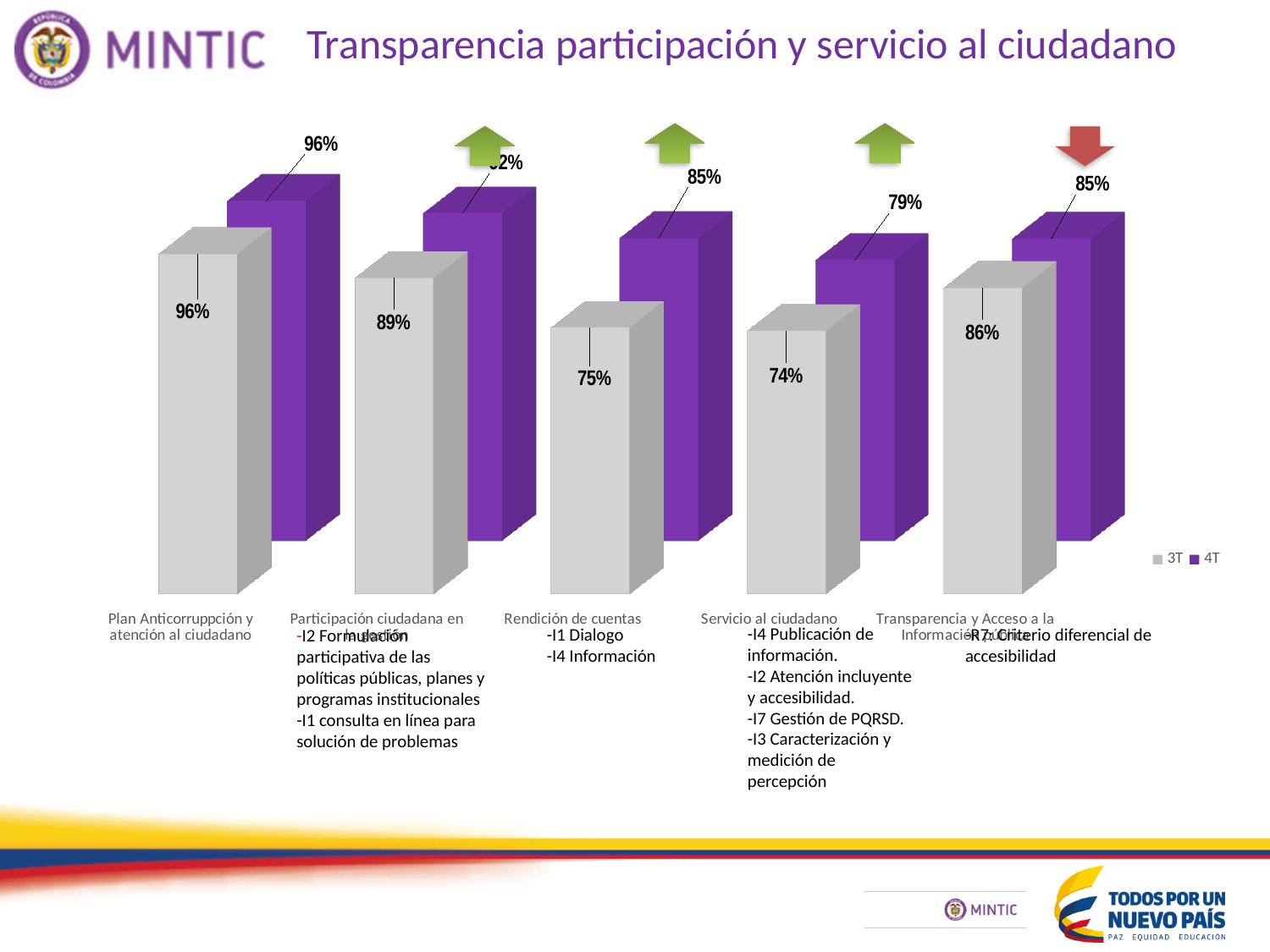
How many categories are shown on the chart? 5 For Transparencia y Acceso a la Información pública, which is larger, the 3T value or the 4T value? 3T What is the 4T value for Rendición de cuentas? 85% What kind of chart is shown on the slide? Bar chart What is the 4T value for Servicio al ciudadano? 79% What is the 3T value for Rendición de cuentas? 75% By how many percentage points does the 4T value exceed the 3T value for Rendición de cuentas? 10 percentage points How many series does the legend list? 2 What is the 3T value for Plan Anticorrupción y atención al ciudadano? 96% What is the 3T value for Transparencia y Acceso a la Información pública? 86% Which category has the lowest 3T value? Servicio al ciudadano Which category has the highest 4T value? Plan Anticorrupción y atención al ciudadano